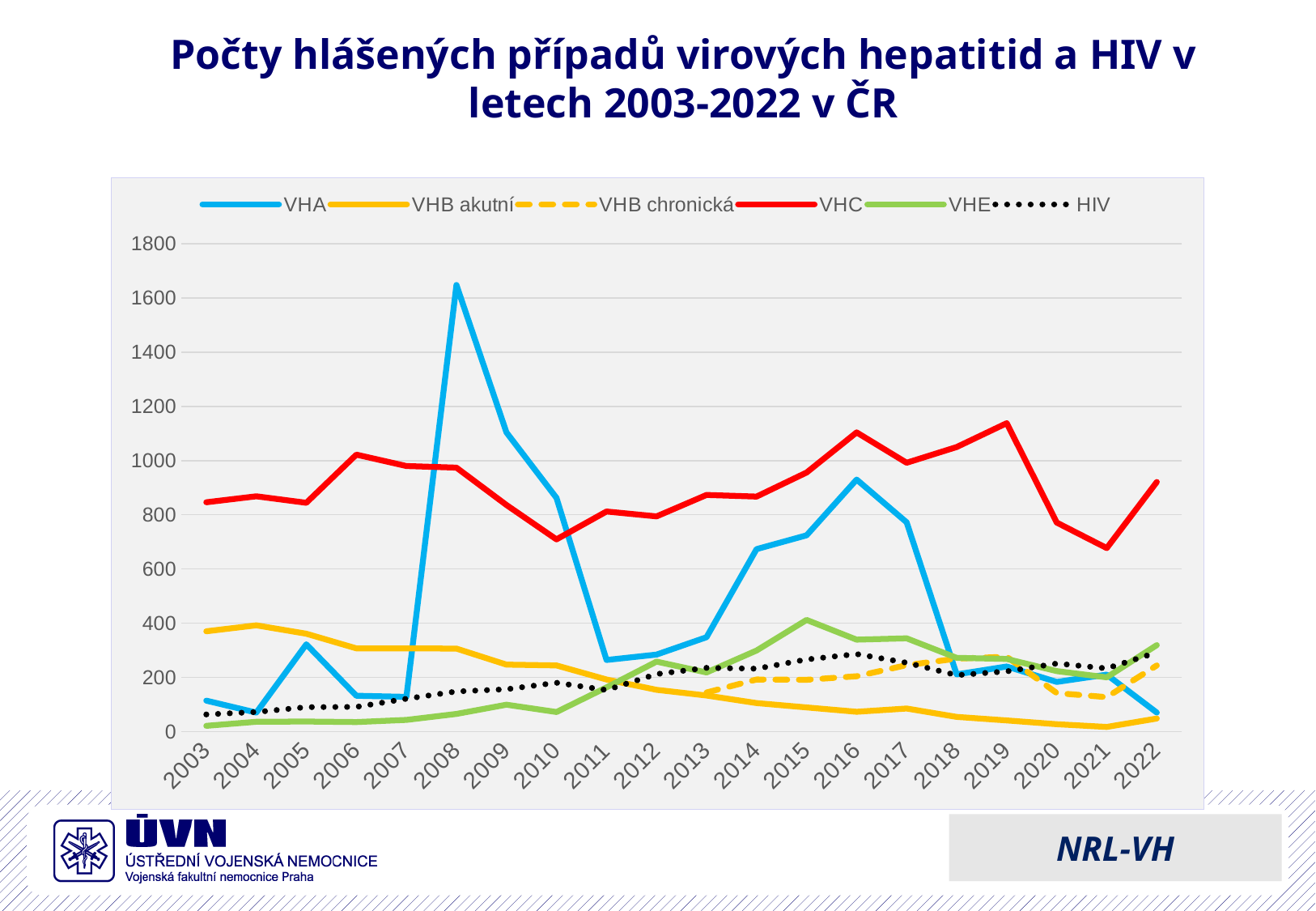
Does the VHB akutní series rise or fall from 2003 to 2022? fall How many years are plotted along the x axis? 20 How many series does the legend list? 6 Is the value for VHA in 2008 greater or less than 1400? greater In 2016, which series has the higher value, VHC or VHA? VHC Which series is drawn as a dotted line? HIV In which year does the VHA series reach its highest value? 2008 Which series has the lowest value in 2021? VHB akutní What kind of chart is shown on the slide? line chart Is the value for VHE in 2015 greater or less than 300? greater Is the value for VHC in 2021 greater or less than 800? less Which series reaches the highest value anywhere on the chart? VHA